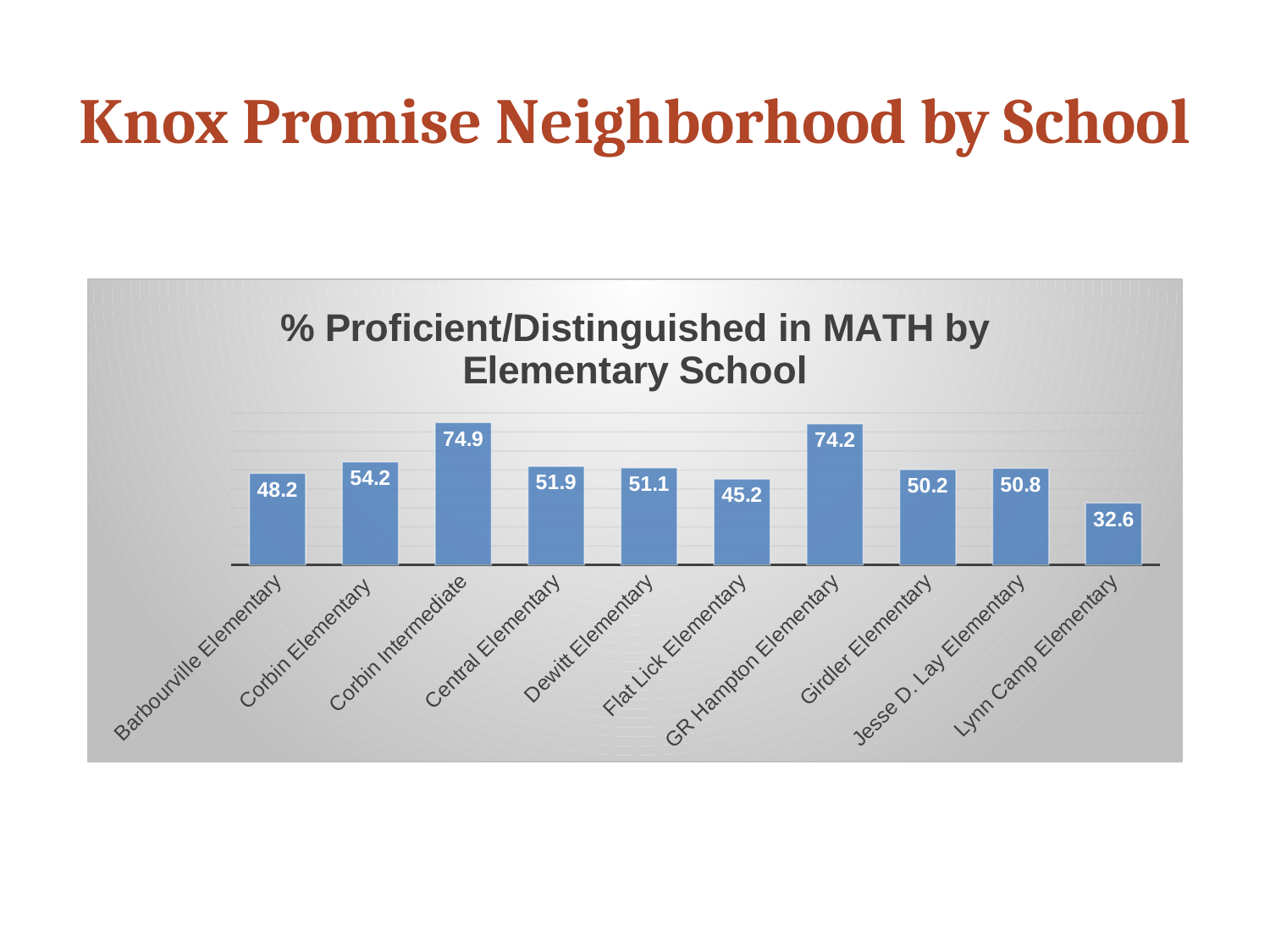
Which is larger, the value for GR Hampton Elementary or the value for Girdler Elementary? GR Hampton Elementary Which school has the lowest value? Lynn Camp Elementary How many schools are shown in the chart? 10 What is the value for Flat Lick Elementary? 45.2 What is the difference between the values for Corbin Elementary and Barbourville Elementary? 6.0 What is the value for Jesse D. Lay Elementary? 50.8 Which school has the highest value? Corbin Intermediate What is the value for Lynn Camp Elementary? 32.6 What is the difference between the values for Corbin Intermediate and Lynn Camp Elementary? 42.3 What kind of chart is shown on the slide? Bar chart What is the value for Corbin Intermediate? 74.9 What is the title of the chart? % Proficient/Distinguished in MATH by Elementary School